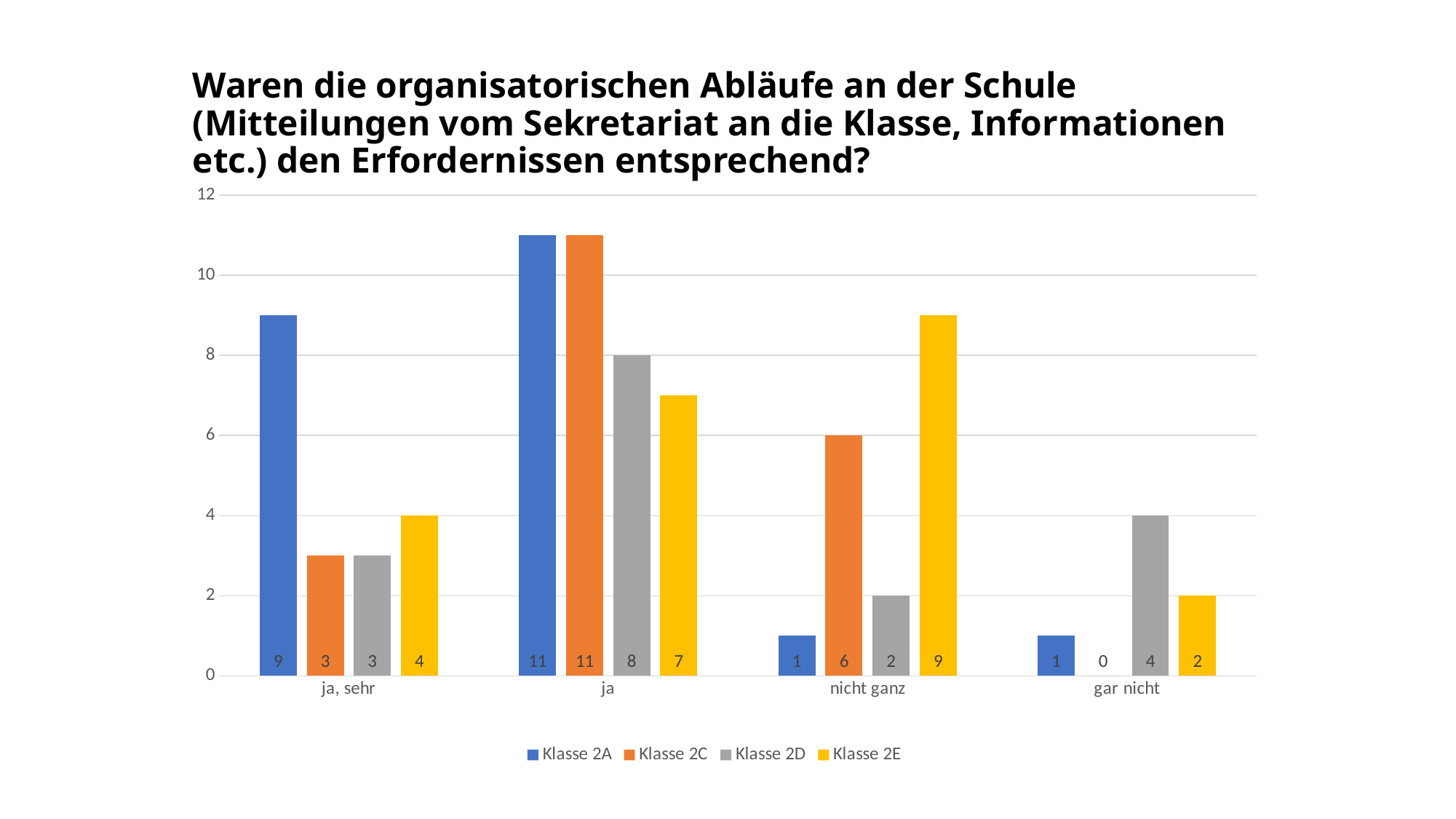
Which category has the highest value for Klasse 2C? ja How many categories are shown on the x axis? 4 What value does Klasse 2A have for "ja, sehr"? 9 Which category has the lowest value for Klasse 2D? nicht ganz How many series does the legend list? 4 Which colour represents Klasse 2E in the chart? yellow What is the difference between Klasse 2A and Klasse 2E for "ja"? 4 What value does Klasse 2E have for "nicht ganz"? 9 What kind of chart is shown on the slide? bar chart What value does Klasse 2D have for "ja"? 8 What value does Klasse 2C have for "gar nicht"? 0 For "nicht ganz", which is larger: Klasse 2C or Klasse 2D? Klasse 2C